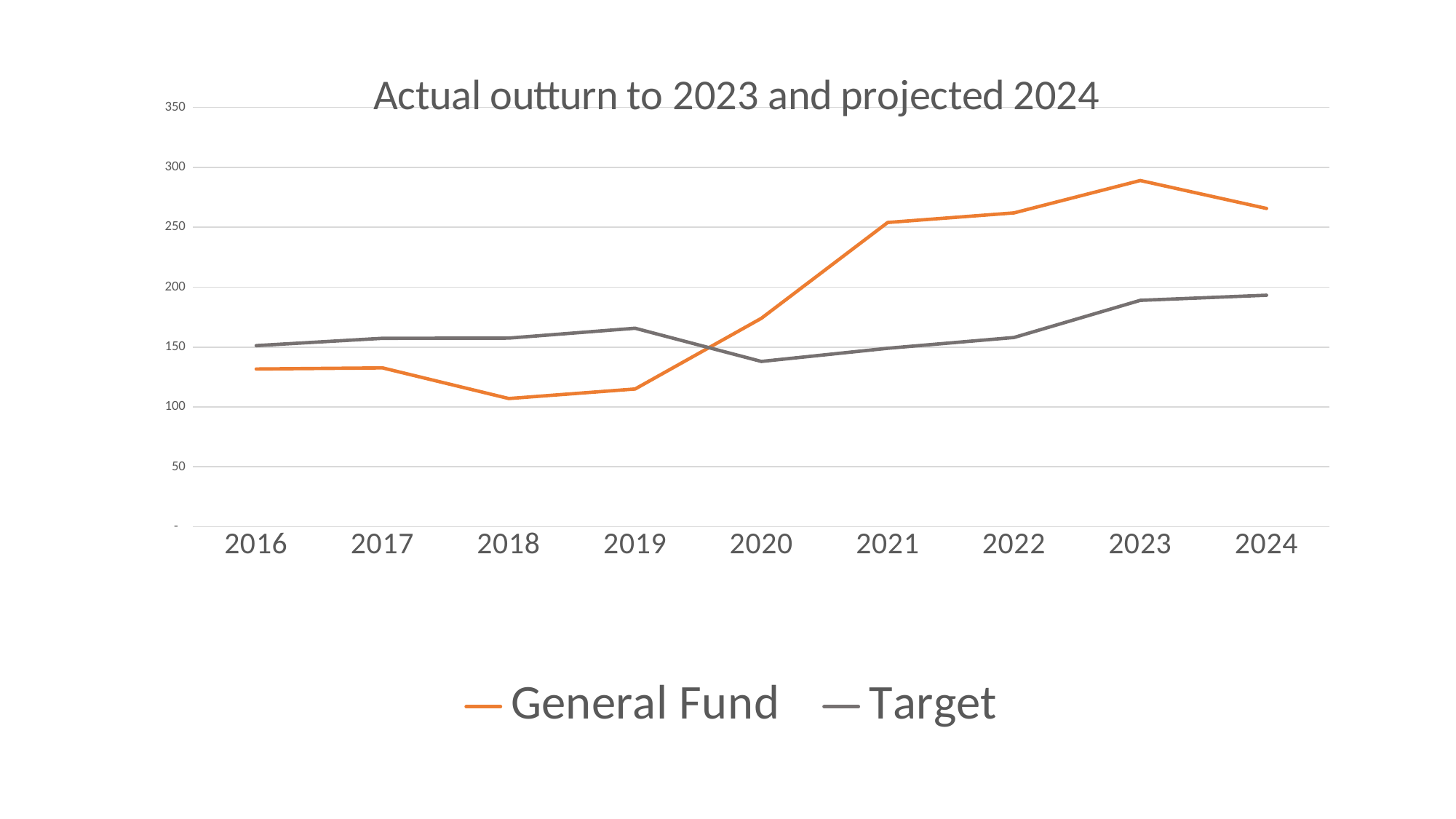
What kind of chart is shown on the slide? line chart In 2016, which is larger: General Fund or Target? Target What is the title of the chart? Actual outturn to 2023 and projected 2024 Does the General Fund line rise or fall between 2019 and 2023? rise In 2023, which is larger: General Fund or Target? General Fund In which year is the General Fund line at its highest? 2023 How many years are shown along the x axis? 9 How many series does the legend list? 2 Is the General Fund value for 2023 greater or less than 250? greater In which year is the General Fund line at its lowest? 2018 In which year is the Target line at its lowest? 2020 Is the Target value for 2020 greater or less than 150? less